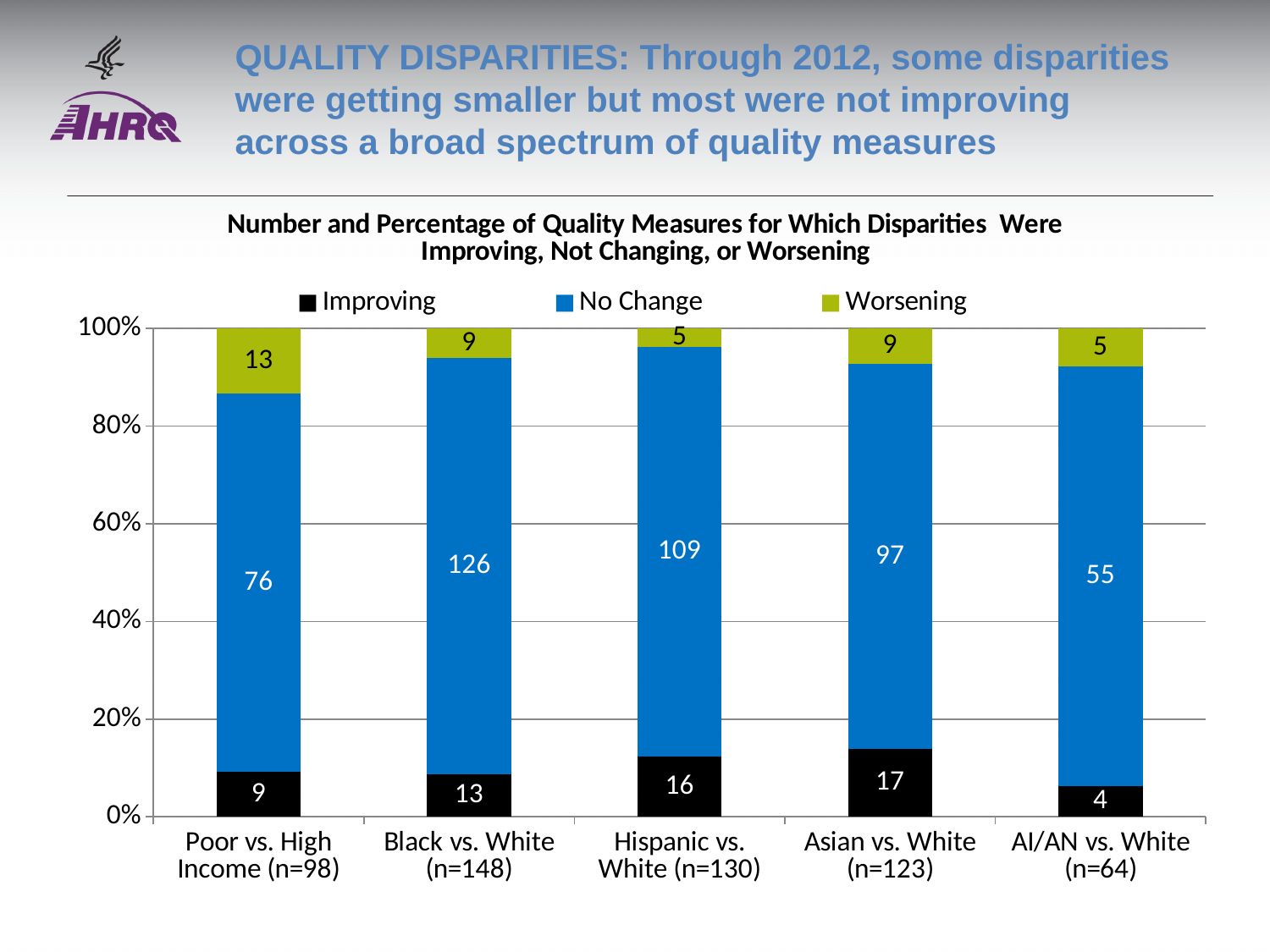
Which category has the lowest Improving value? AI/AN vs. White (n=64) What is the total of the stacked bar for Asian vs. White (n=123)? 123 What is the No Change value for Black vs. White (n=148)? 126 Which is larger: the Improving value for Hispanic vs. White (n=130) or for Black vs. White (n=148)? Hispanic vs. White (n=130) What is the Worsening value for Poor vs. High Income (n=98)? 13 Which series is shown in green in the legend? Worsening What is the difference between the No Change values for Hispanic vs. White (n=130) and AI/AN vs. White (n=64)? 54 Which category has the highest No Change value? Black vs. White (n=148) How many categories are shown on the x axis? 5 What is the Improving value for Asian vs. White (n=123)? 17 How many series does the legend list? 3 What kind of chart is shown on the slide? Stacked bar chart